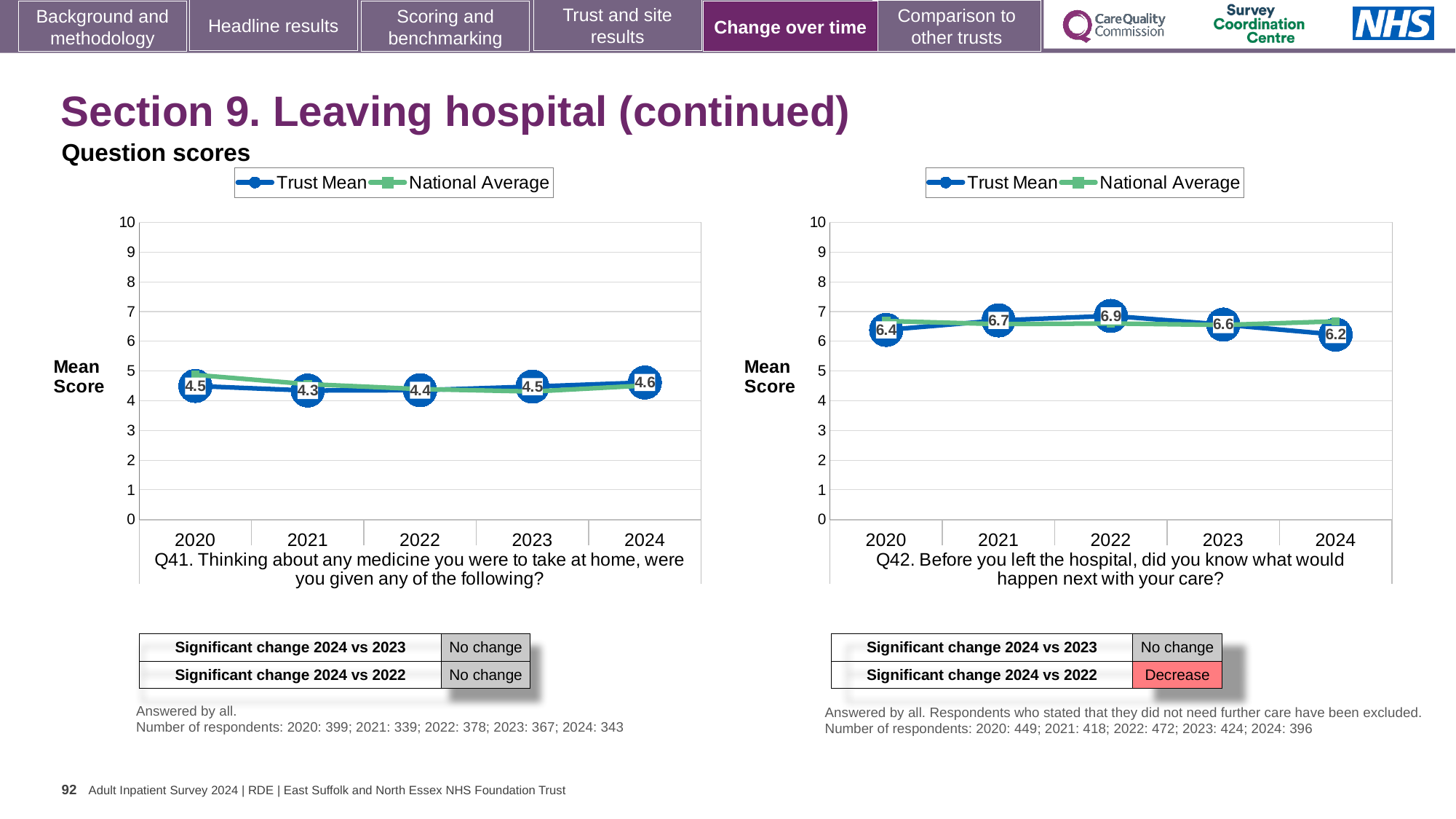
What type of chart is used for Q42? Line chart In the Q42 chart, what is the Trust Mean score for 2022? 6.9 In the Q41 chart, what is the Trust Mean score for 2021? 4.3 In the Q42 chart, what is the difference between the Trust Mean scores for 2022 and 2024? 0.7 How many years are plotted on the x axis of the Q42 chart? 5 In the Q41 chart, which year has the lowest Trust Mean score? 2021 In the Q41 chart, is the Trust Mean score for 2024 greater or less than 5? less In the Q41 chart, what is the Trust Mean score for 2024? 4.6 In the Q42 chart, which year has the lowest Trust Mean score? 2024 How many series does the legend of the Q41 chart list? 2 In the Q42 chart, which year has the highest Trust Mean score? 2022 In the Q42 chart, what is the Trust Mean score for 2024? 6.2